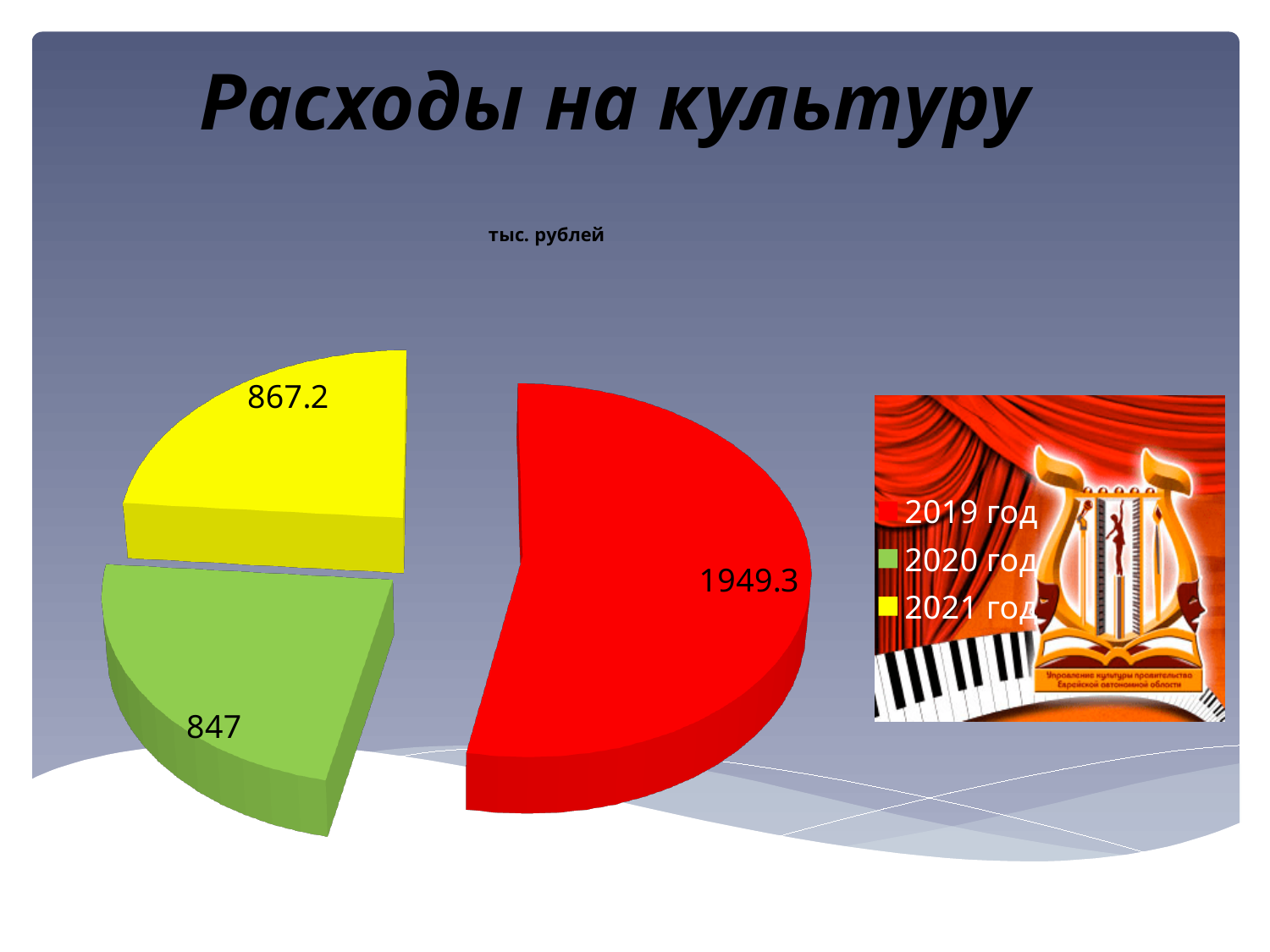
What is the total of all slices in the pie chart? 3663.5 Which year has the smallest slice in the pie chart? 2020 год What is the value for 2020 год in the pie chart? 847 What is the difference between the values for 2019 год and 2020 год? 1102.3 What type of chart is shown on the slide? Pie chart Which year has the largest slice in the pie chart? 2019 год What is the value for 2019 год in the pie chart? 1949.3 Which is larger, the value for 2020 год or 2021 год? 2021 год How many slices does the pie chart have? 3 What is the value for 2021 год in the pie chart? 867.2 What is the difference between the values for 2021 год and 2020 год? 20.2 What colour is the slice for 2019 год? Red